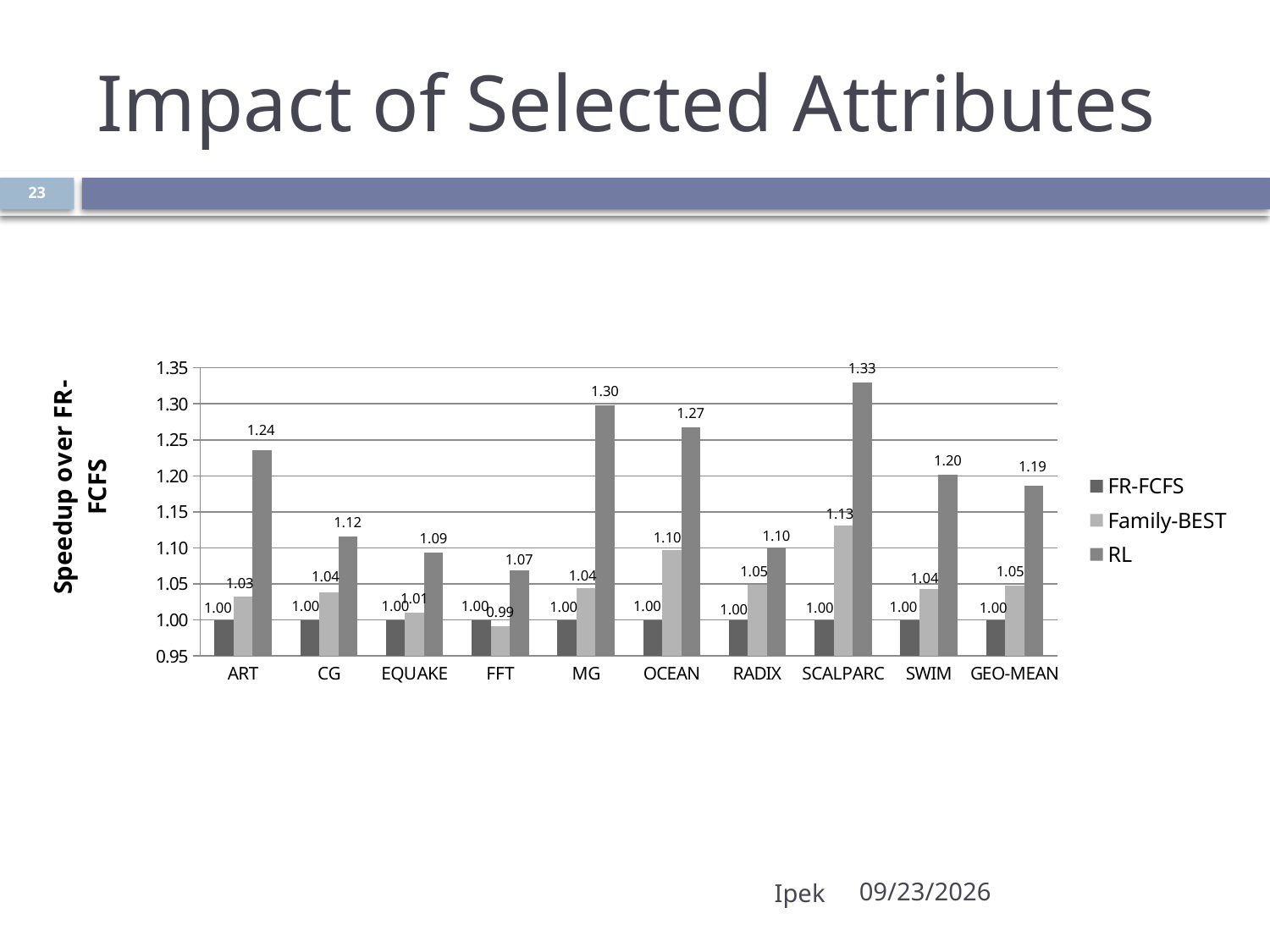
What is the Family-BEST speedup for OCEAN? 1.10 What is the label of the y axis? Speedup over FR-FCFS What is the RL value for GEO-MEAN? 1.19 How many series does the legend list? 3 What is the difference between the RL and Family-BEST speedups for MG? 0.26 Which is larger for SWIM: the RL speedup or the Family-BEST speedup? RL What kind of chart is shown on the slide? Bar chart How many benchmark categories are shown on the x axis? 10 Which benchmark has the lowest Family-BEST speedup? FFT Which benchmark has the highest RL speedup? SCALPARC Is the RL value for ART greater or less than 1.20? greater What is the RL speedup for SCALPARC? 1.33